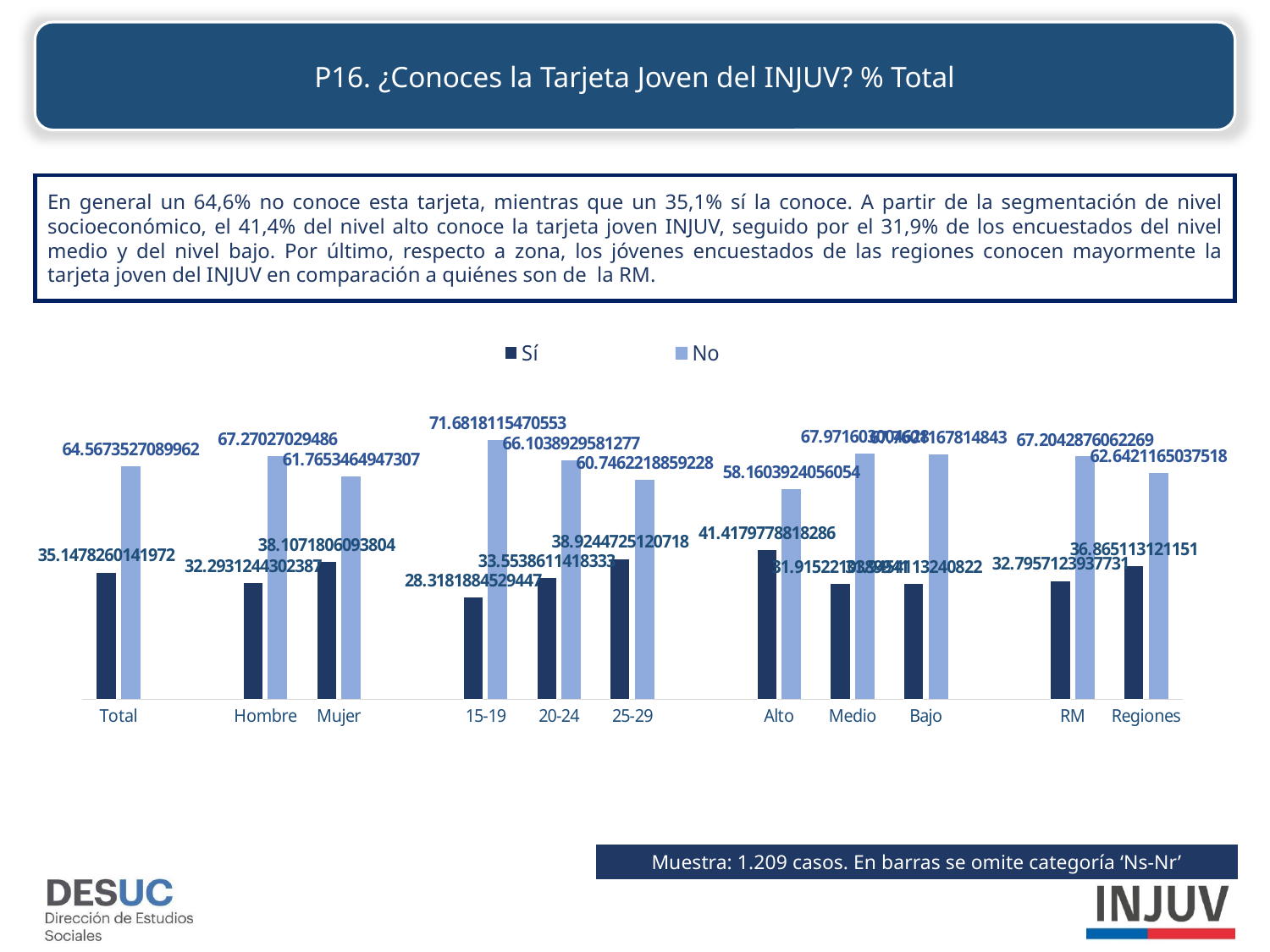
What is the value of the 'No' bar for 15-19? 71.6818115470553 What is the value of the 'Sí' bar for Alto? 41.4179778818286 What is the difference between the 'No' and 'Sí' values for Total? 29.419526694799 What type of chart is shown on the slide? bar chart What are the two series named in the legend? Sí and No What is the value of the 'Sí' bar for Total? 35.1478260141972 How many categories are shown along the x axis? 11 Which category has the lowest 'Sí' value? 15-19 Which category has the highest 'Sí' value? Alto What is the value of the 'No' bar for Regiones? 62.6421165037518 Which is larger, the 'Sí' value for Hombre or the 'Sí' value for Mujer? Mujer How many series does the legend list? 2